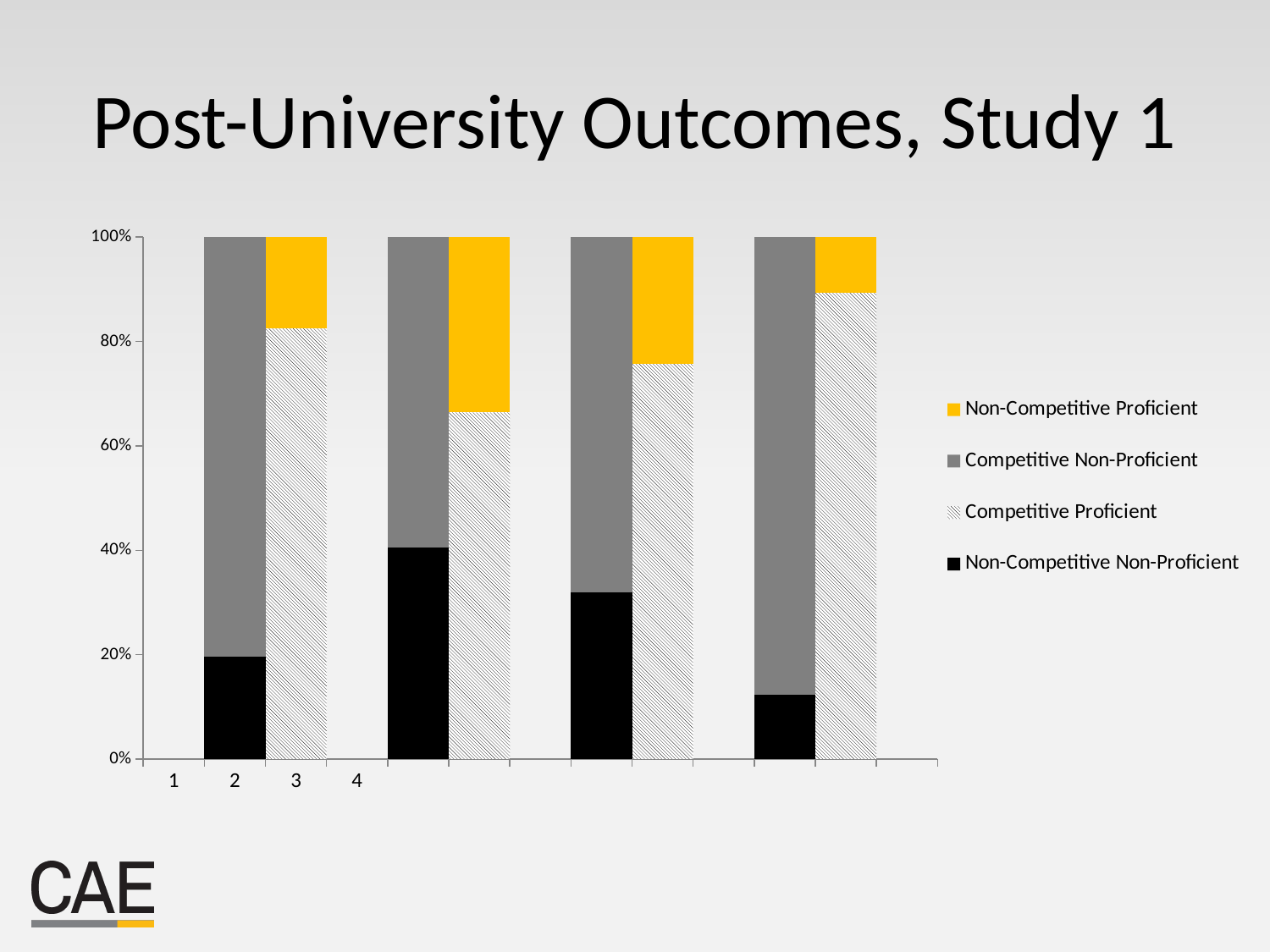
Is the Non-Competitive Non-Proficient value in the third group of bars from the left greater or less than 20%? greater Is the Non-Competitive Non-Proficient value in the fourth group of bars from the left greater or less than 20%? less How many groups of bars are plotted in the chart? 4 What kind of chart is shown on the slide? Stacked bar chart What is the title of the slide containing the chart? Post-University Outcomes, Study 1 Is the Competitive Proficient value in the fourth group of bars from the left greater or less than 80%? greater Which legend entry is shown in yellow? Non-Competitive Proficient Which group of bars has the smallest Non-Competitive Proficient segment? The fourth group from the left How many series does the legend list? 4 Which group of bars has the largest Non-Competitive Non-Proficient segment? The second group from the left